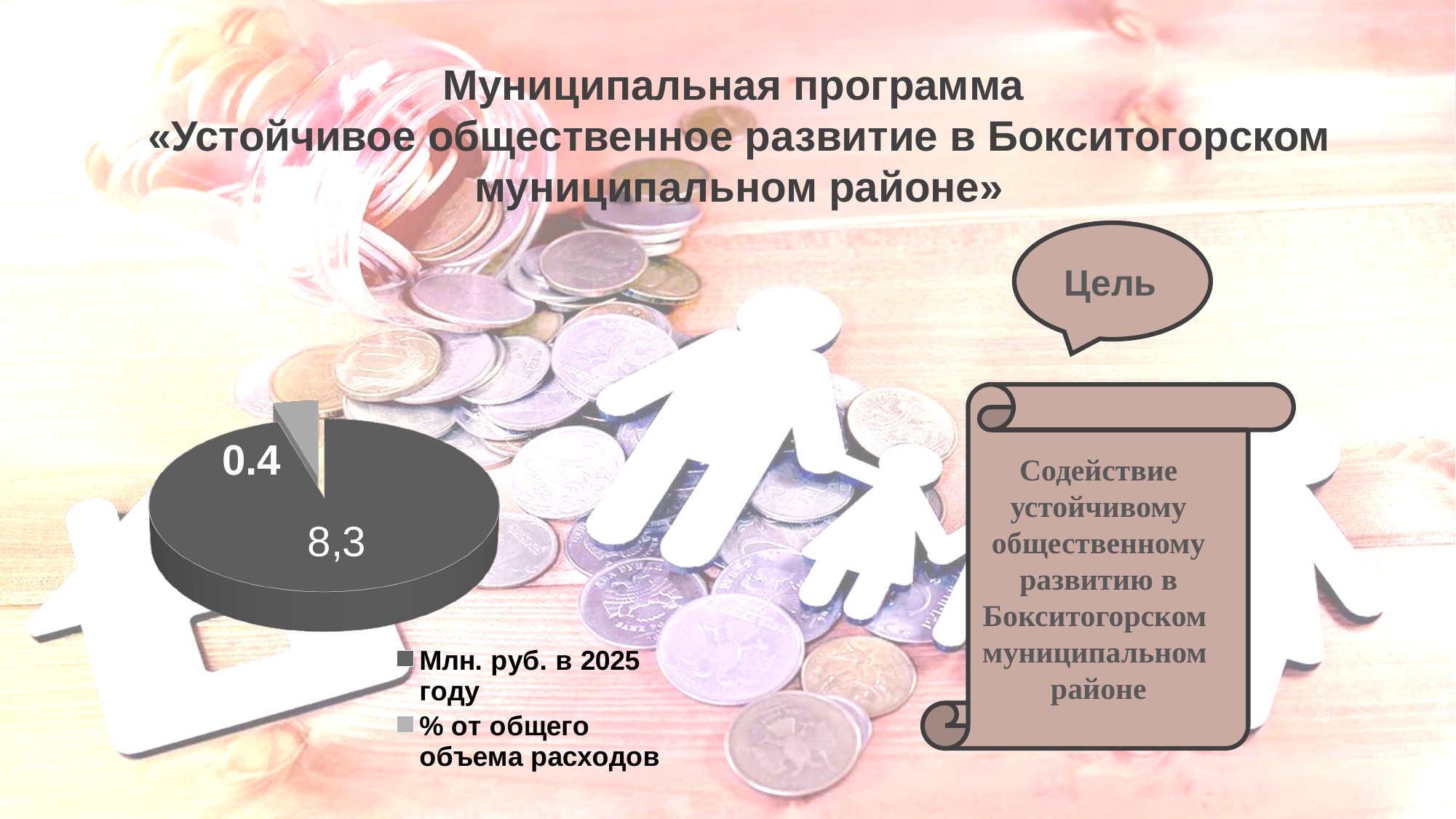
What colour is the "Млн. руб. в 2025 году" slice in the pie chart? dark grey Which slice of the pie chart is the smallest? % от общего объема расходов What value is shown for "% от общего объема расходов" in the pie chart? 0.4 What value is shown for "Млн. руб. в 2025 году" in the pie chart? 8,3 How many slices does the pie chart have? 2 Which slice of the pie chart is the largest? Млн. руб. в 2025 году How many entries does the legend of the pie chart list? 2 What colour is the "% от общего объема расходов" slice in the pie chart? light grey What kind of chart is shown on the slide? pie chart Which is larger in the pie chart: the value for "Млн. руб. в 2025 году" or the value for "% от общего объема расходов"? Млн. руб. в 2025 году